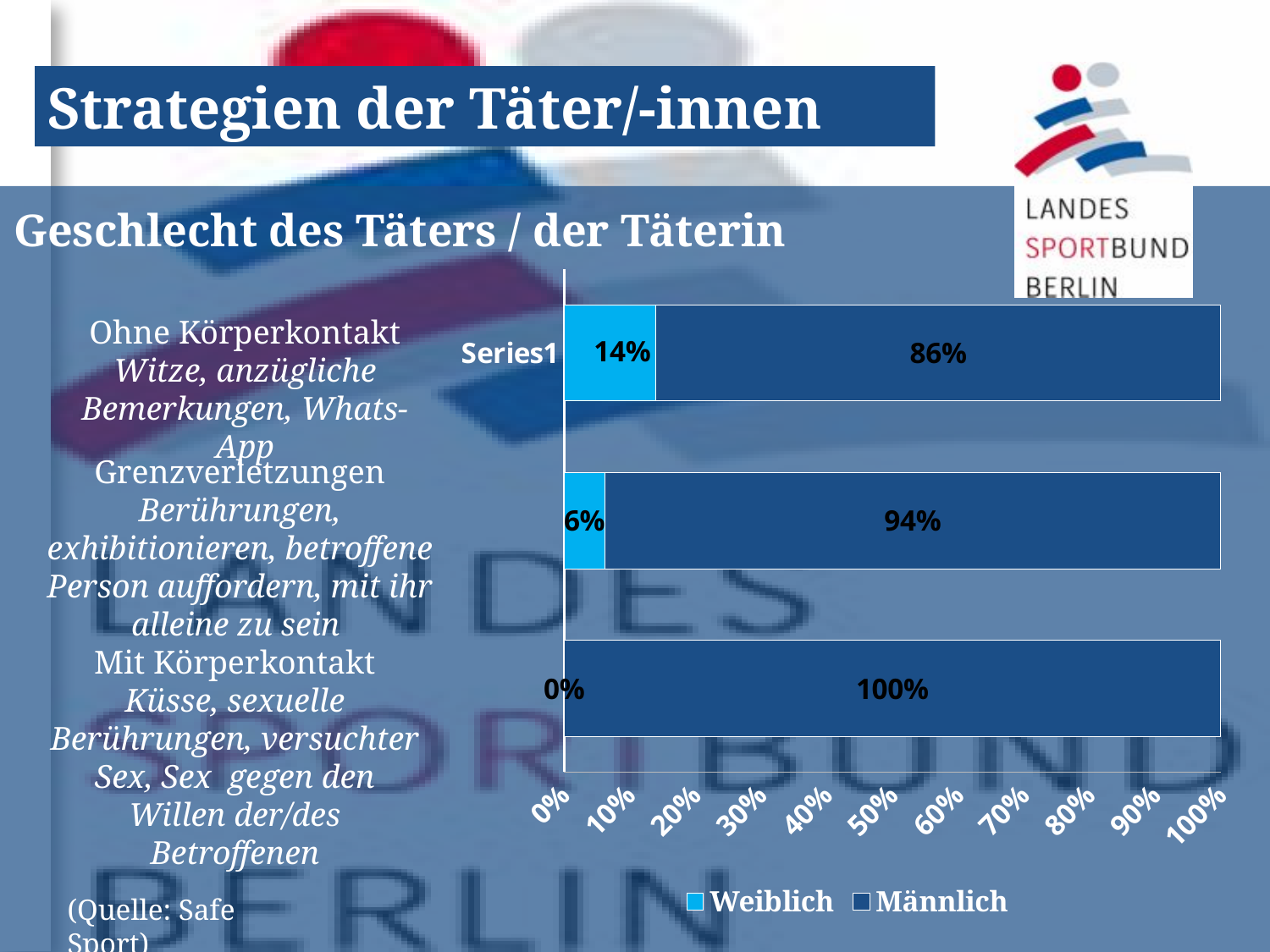
What is the Weiblich value for the top bar (Ohne Körperkontakt)? 14% Which is larger in the middle bar: the Weiblich value or the Männlich value? Männlich What is the Männlich value for the bottom bar (Mit Körperkontakt)? 100% Which bar has the highest Weiblich value? the top bar (Ohne Körperkontakt) What is the Männlich value for the top bar (Ohne Körperkontakt)? 86% Which bar has the lowest Männlich value? the top bar (Ohne Körperkontakt) What are the two series named in the chart legend? Weiblich and Männlich How many series does the chart legend list? 2 What is the Weiblich value for the middle bar (Grenzverletzungen)? 6% What is the difference between the Männlich values of the middle bar (94%) and the top bar (86%)? 8% How many bars are plotted in the chart? 3 What kind of chart is shown on the slide? stacked bar chart